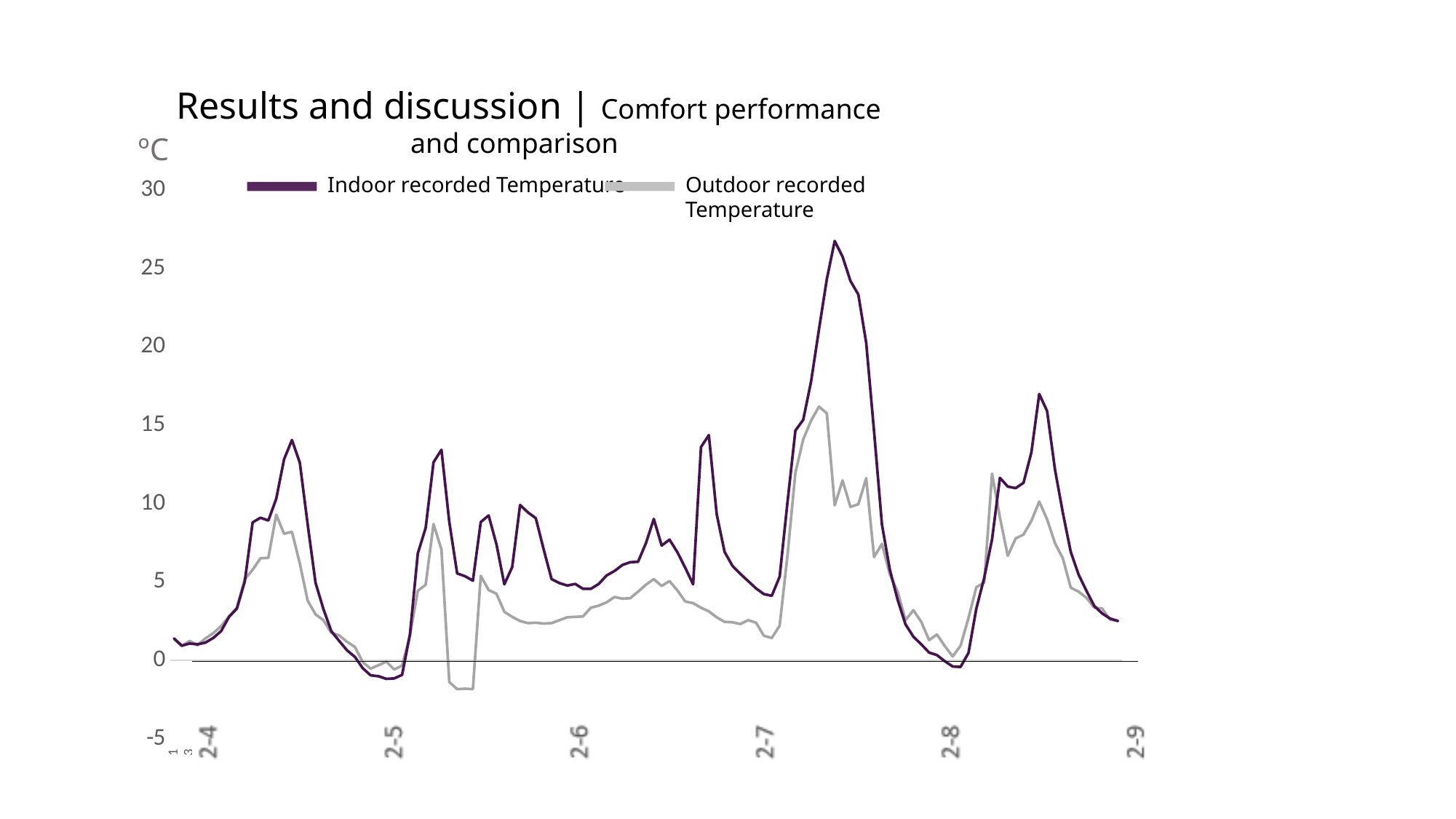
How many series does the legend list? 2 What kind of chart is shown on the slide? Line chart Is the lowest value of the Outdoor recorded Temperature line shortly after 2-5 greater or less than 0? less Between which two x-axis labels does the Indoor recorded Temperature line reach its highest peak? 2-7 and 2-8 Is the peak of the Outdoor recorded Temperature line between 2-7 and 2-8 greater or less than 10? greater Is the highest peak of the Indoor recorded Temperature line greater or less than 25? greater Which series reaches the highest value on the chart? Indoor recorded Temperature What unit is shown on the y axis of the chart? °C Between 2-7 and 2-8, which series reaches a higher peak, Indoor recorded Temperature or Outdoor recorded Temperature? Indoor recorded Temperature How many date labels are shown along the x axis? 6 What are the two series named in the legend? Indoor recorded Temperature and Outdoor recorded Temperature